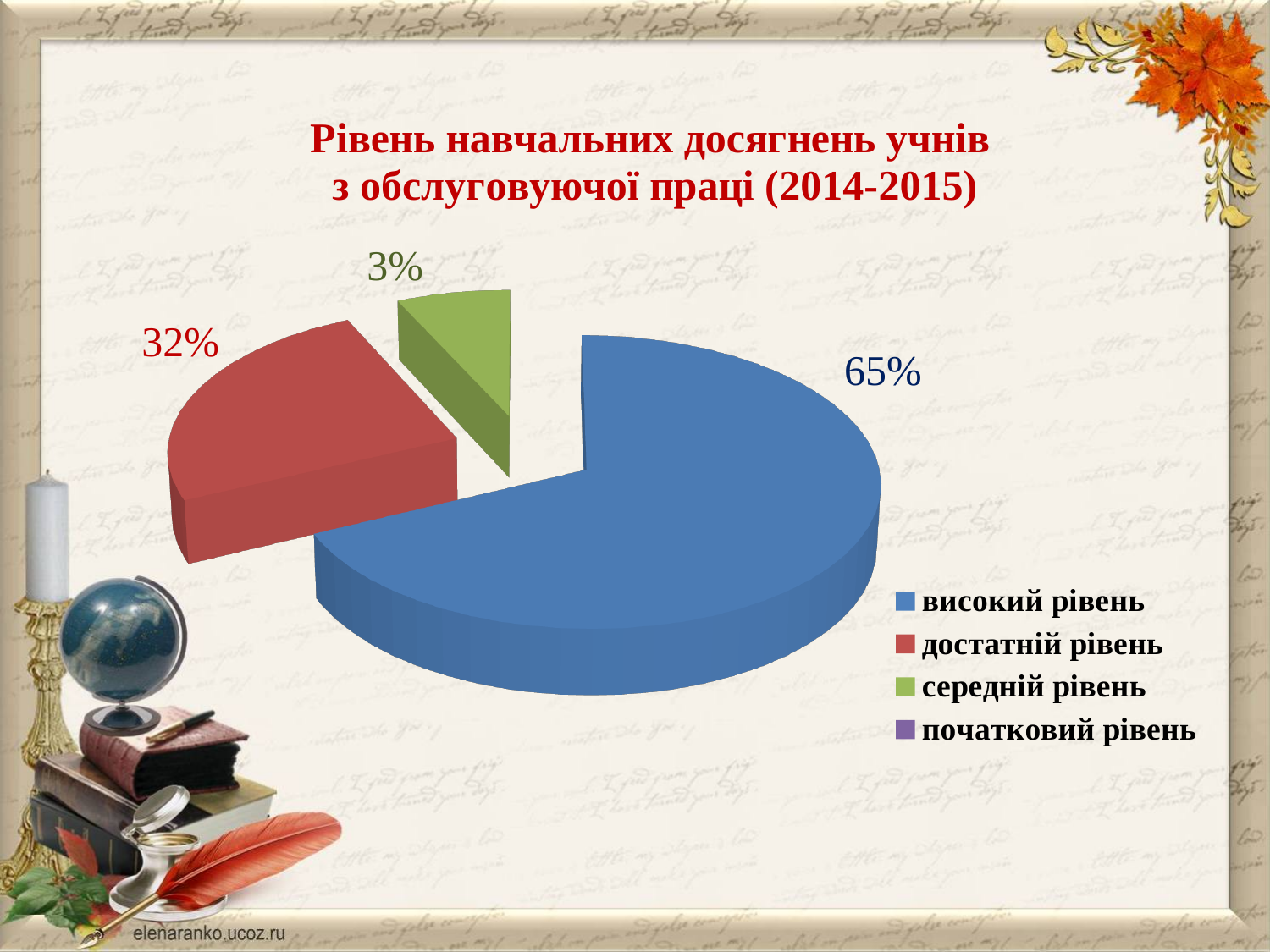
What percentage is shown for високий рівень? 65% What is the difference between the shares for високий рівень and достатній рівень? 33% What colour is the slice for високий рівень? blue How many slices have a percentage label on the chart? 3 What type of chart is shown on the slide? pie chart How many entries does the legend list? 4 Which of the labelled slices has the smallest share of the pie? середній рівень What percentage is shown for достатній рівень? 32% What is the title of the chart? Рівень навчальних досягнень учнів з обслуговуючої праці (2014-2015) Which is larger, the share for достатній рівень or the share for середній рівень? достатній рівень Which category has the largest share of the pie? високий рівень What percentage is shown for середній рівень? 3%